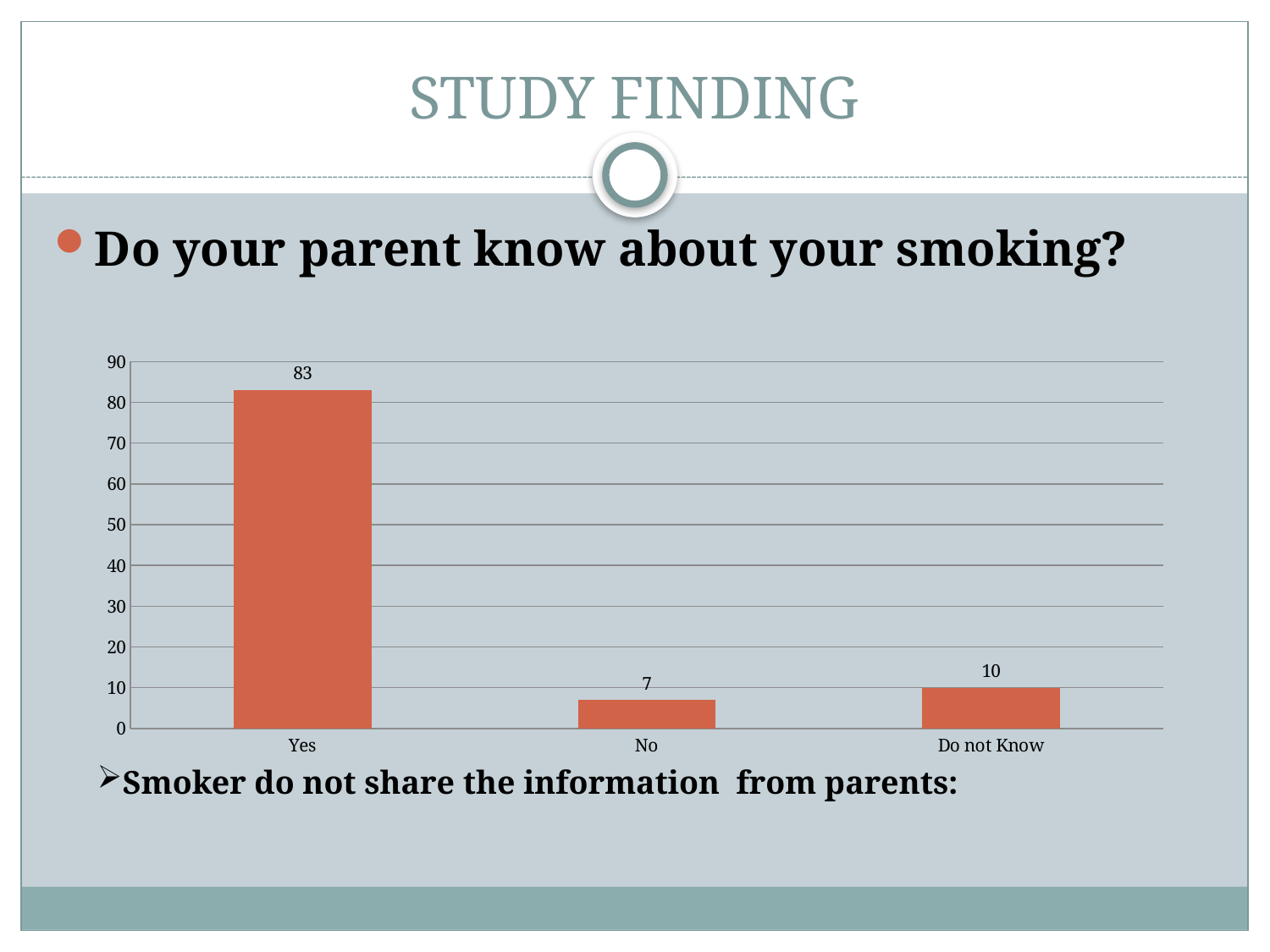
Is the value for Yes greater or less than 80? greater What is the difference between the values for Do not Know and No? 3 What kind of chart is shown on the slide? bar chart What is the value for Do not Know? 10 What is the highest value shown on the y axis? 90 Which category has the highest value? Yes What is the value for Yes? 83 What is the difference between the values for Yes and No? 76 Which is larger, the value for No or the value for Do not Know? Do not Know How many categories are shown on the x axis? 3 Which category has the lowest value? No What is the value for No? 7